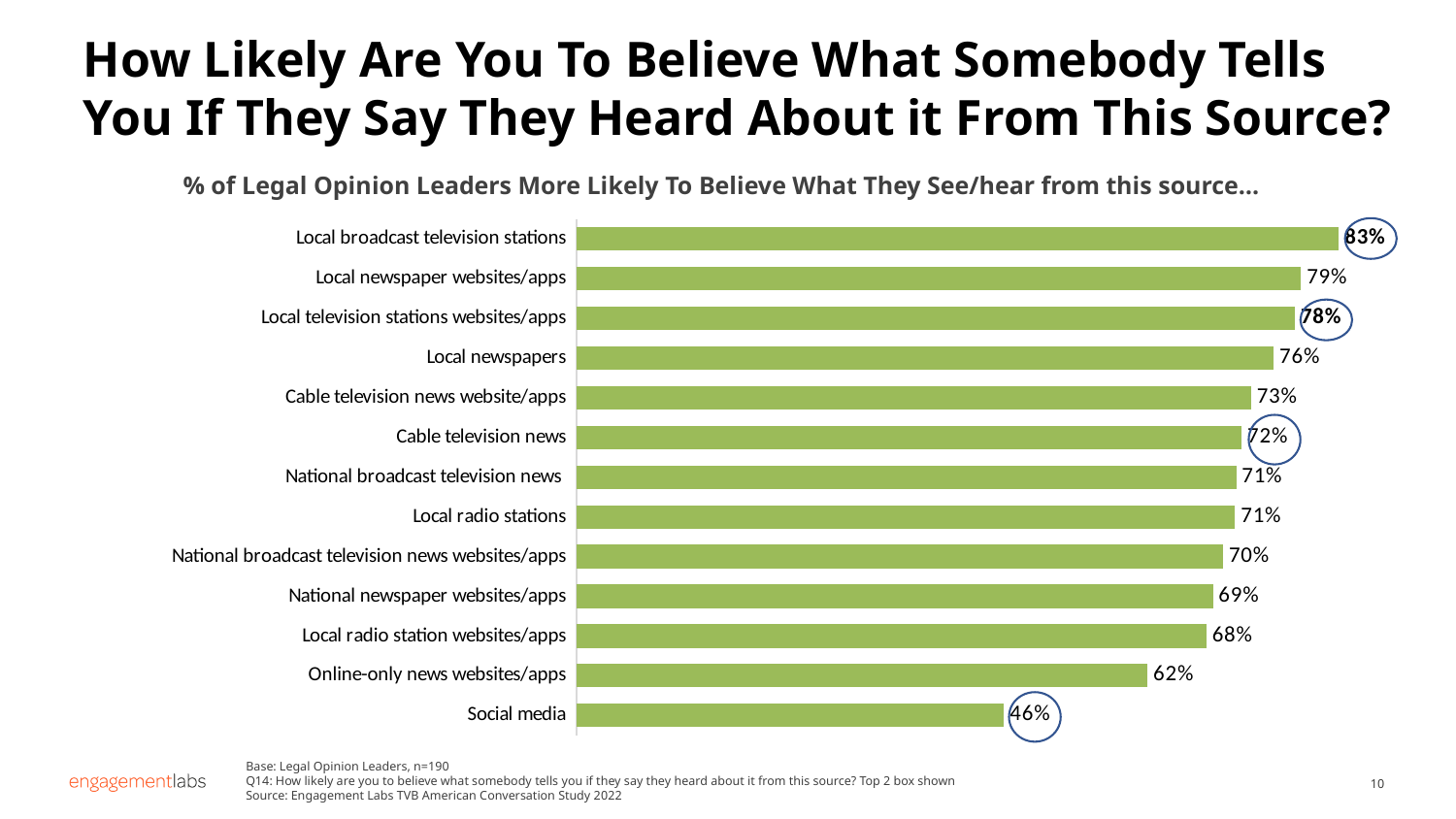
What type of chart is shown on the slide? Bar chart What is the difference between the values for Local newspaper websites/apps and Local newspapers? 3% What is the difference between the values for Local broadcast television stations and Social media? 37% What is the value shown for Cable television news website/apps? 73% Which source has the highest percentage in the chart? Local broadcast television stations How many sources have a value of exactly 71%? 2 What percentage of Legal Opinion Leaders are more likely to believe what they hear from local broadcast television stations? 83% Which source has the lowest percentage in the chart? Social media Which has a higher value: Cable television news or Online-only news websites/apps? Cable television news What is the value shown for Online-only news websites/apps? 62% What is the value shown for Social media? 46% How many sources (categories) are shown in the chart? 13